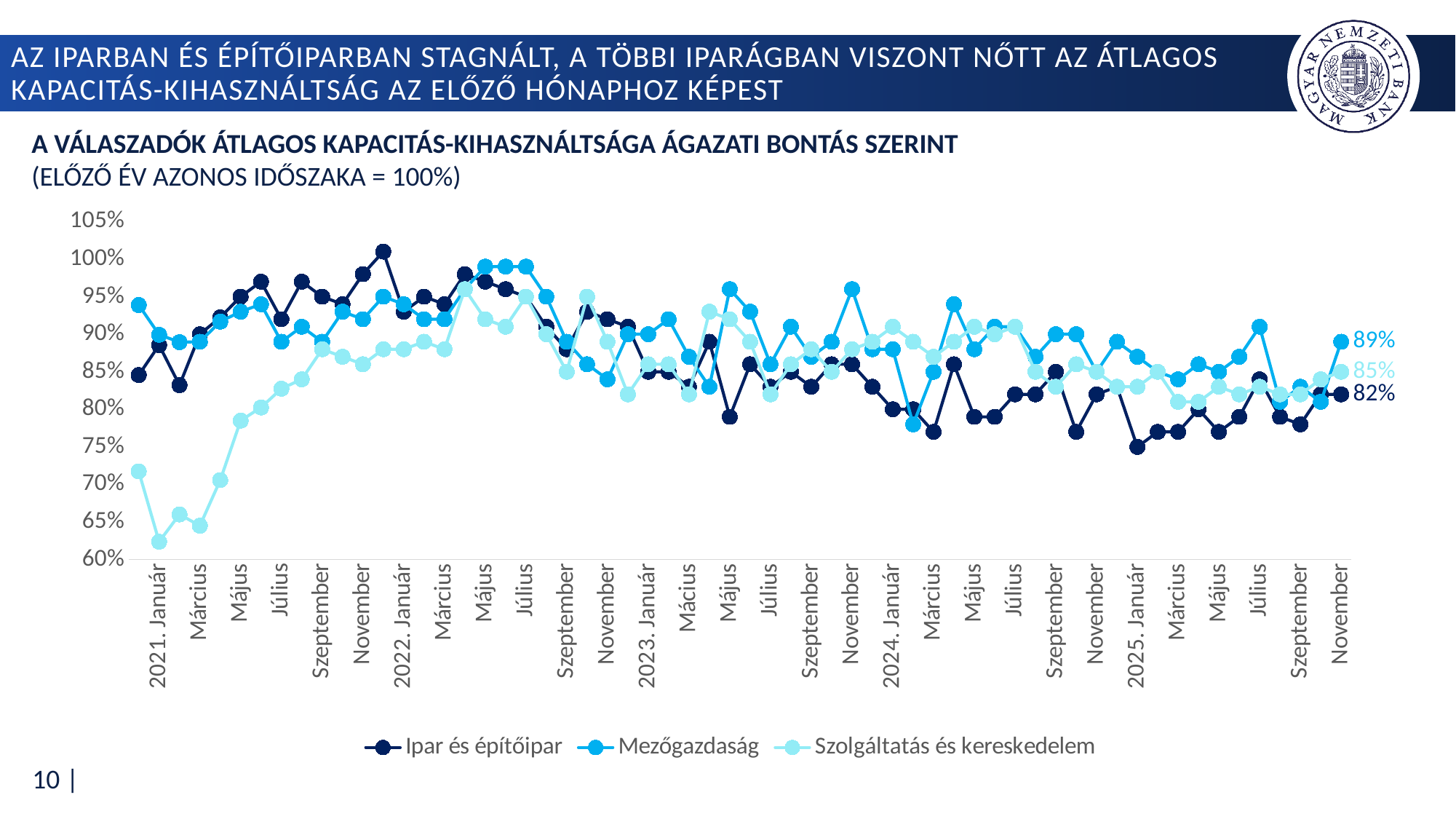
What is the title of the chart? A válaszadók átlagos kapacitás-kihasználtsága ágazati bontás szerint (előző év azonos időszaka = 100%) Does the Szolgáltatás és kereskedelem series rise or fall over the course of 2021? Rise Which series has the lowest value at the last point (November 2025)? Ipar és építőipar Is the value for Szolgáltatás és kereskedelem in 2021. Január greater or less than 75%? less What is the value shown for Mezőgazdaság at the last point (November 2025)? 89% What kind of chart is shown on the slide? Line chart What is the value shown for Ipar és építőipar at the last point (November 2025)? 82% How many series does the legend list? 3 What is the value shown for Szolgáltatás és kereskedelem at the last point (November 2025)? 85% At the last point (November 2025), which is larger: Mezőgazdaság or Szolgáltatás és kereskedelem? Mezőgazdaság Which series has the highest value at the last point (November 2025)? Mezőgazdaság What is the difference between the Mezőgazdaság and Ipar és építőipar values at the last point (November 2025)? 7 percentage points